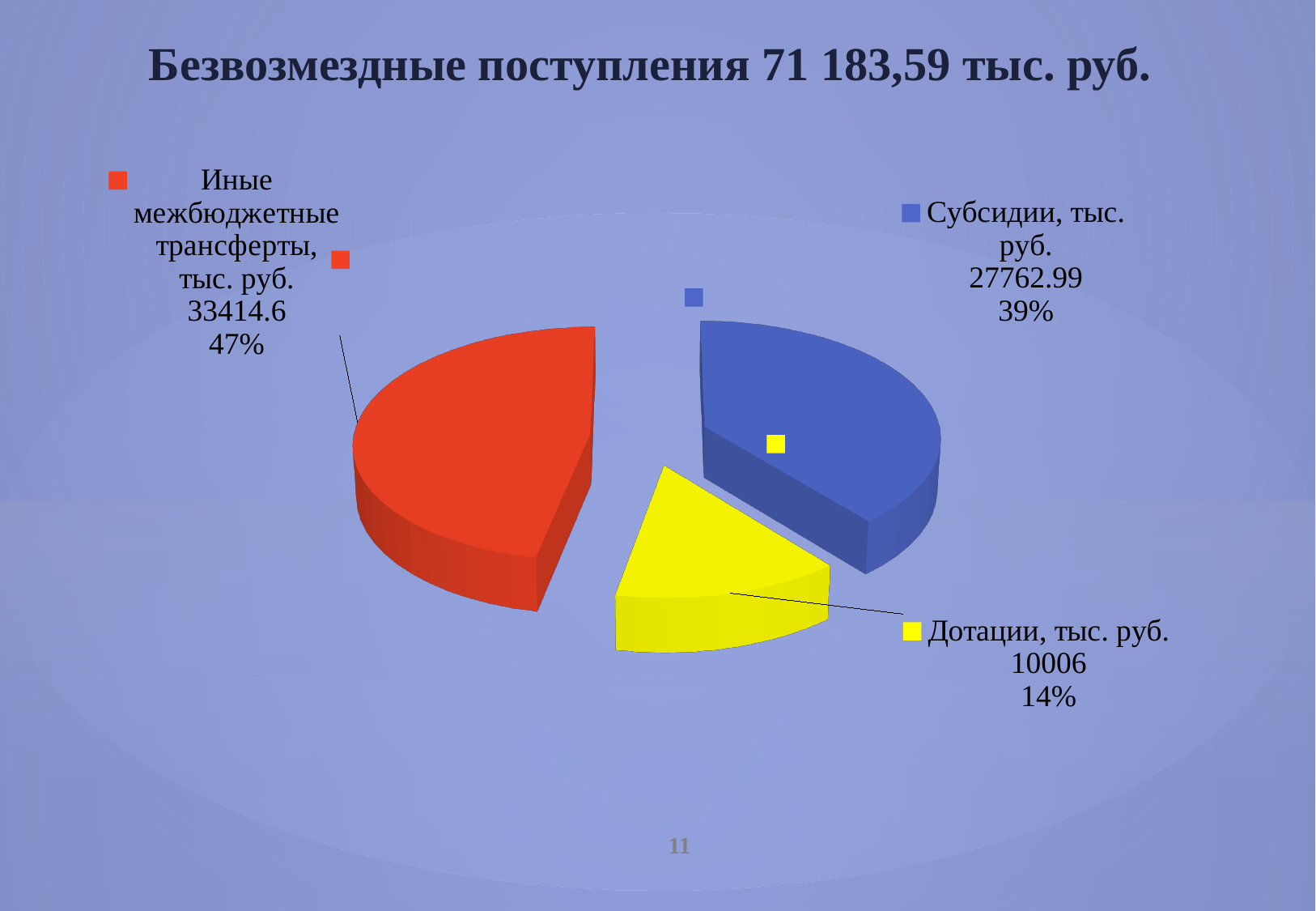
How many slices does the pie chart have? 3 Which category has the largest slice? Иные межбюджетные трансферты What share of the pie does Субсидии represent? 39% What is the value for Субсидии, тыс. руб.? 27762.99 What is the value for Дотации, тыс. руб.? 10006 Which is larger, the value for Субсидии or the value for Дотации? Субсидии What kind of chart is shown on the slide? Pie chart What is the difference between the values for Субсидии and Дотации? 17756.99 What share of the pie does Иные межбюджетные трансферты represent? 47% Which category has the smallest slice? Дотации What share of the pie does Дотации represent? 14% What is the value for Иные межбюджетные трансферты, тыс. руб.? 33414.6